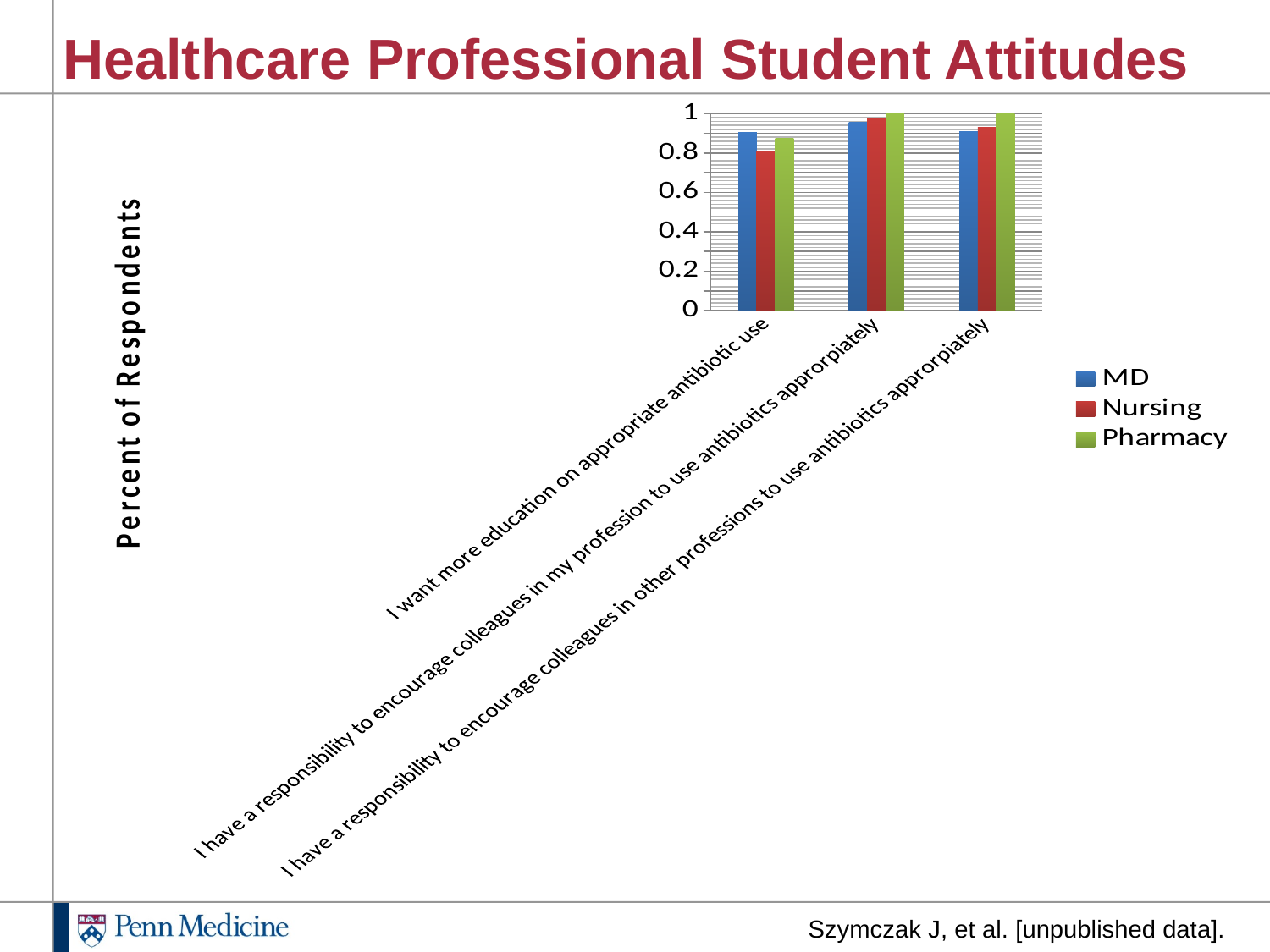
Is the MD value for "I want more education on appropriate antibiotic use" greater or less than 0.8? greater Is the Nursing value for "I want more education on appropriate antibiotic use" greater or less than 0.6? greater How many statement categories are shown on the x axis? 3 What kind of chart is shown on the slide? bar chart For "I want more education on appropriate antibiotic use", which is larger: the MD value or the Nursing value? MD How many series does the legend list? 3 For "I want more education on appropriate antibiotic use", which series has the lowest value? Nursing What is the label on the vertical axis? Percent of Respondents Which is larger: the Pharmacy value for "I want more education on appropriate antibiotic use" or the Pharmacy value for "I have a responsibility to encourage colleagues in my profession to use antibiotics approrpiately"? I have a responsibility to encourage colleagues in my profession to use antibiotics approrpiately Which bar is the lowest in the whole chart? Nursing for "I want more education on appropriate antibiotic use" What are the three series named in the legend? MD, Nursing, Pharmacy For "I have a responsibility to encourage colleagues in other professions to use antibiotics approrpiately", which series has the highest value? Pharmacy